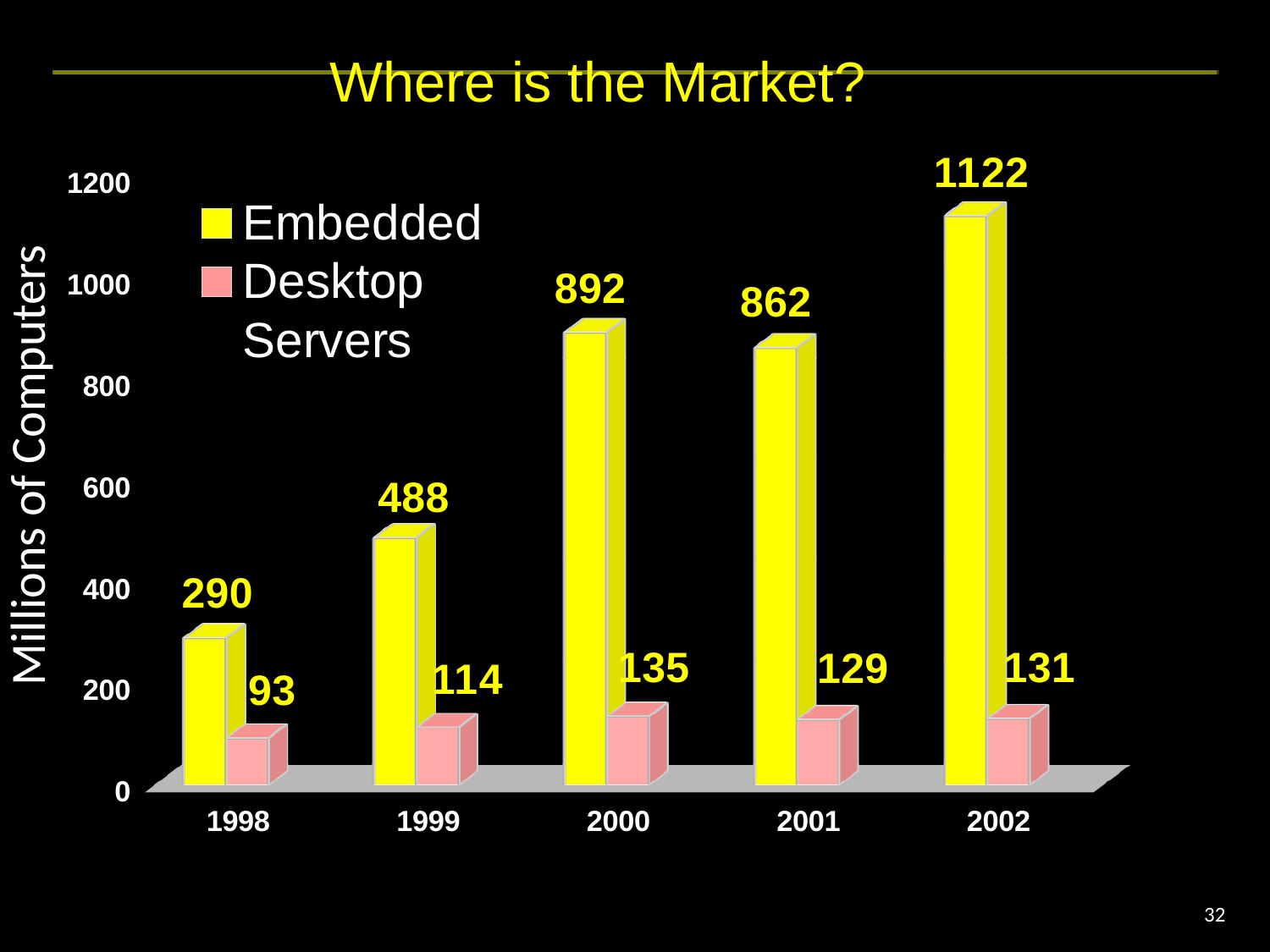
What is the Embedded value for 2002? 1122 Is the Embedded value for 2001 greater or less than 800? greater What is the difference between the Embedded values for 2000 and 2001? 30 What is the title of the chart? Where is the Market? How many years are shown on the x axis? 5 How many series does the legend list? 3 Which year has the highest Embedded value? 2002 What is the Embedded value for 1999? 488 What kind of chart is shown on the slide? bar chart